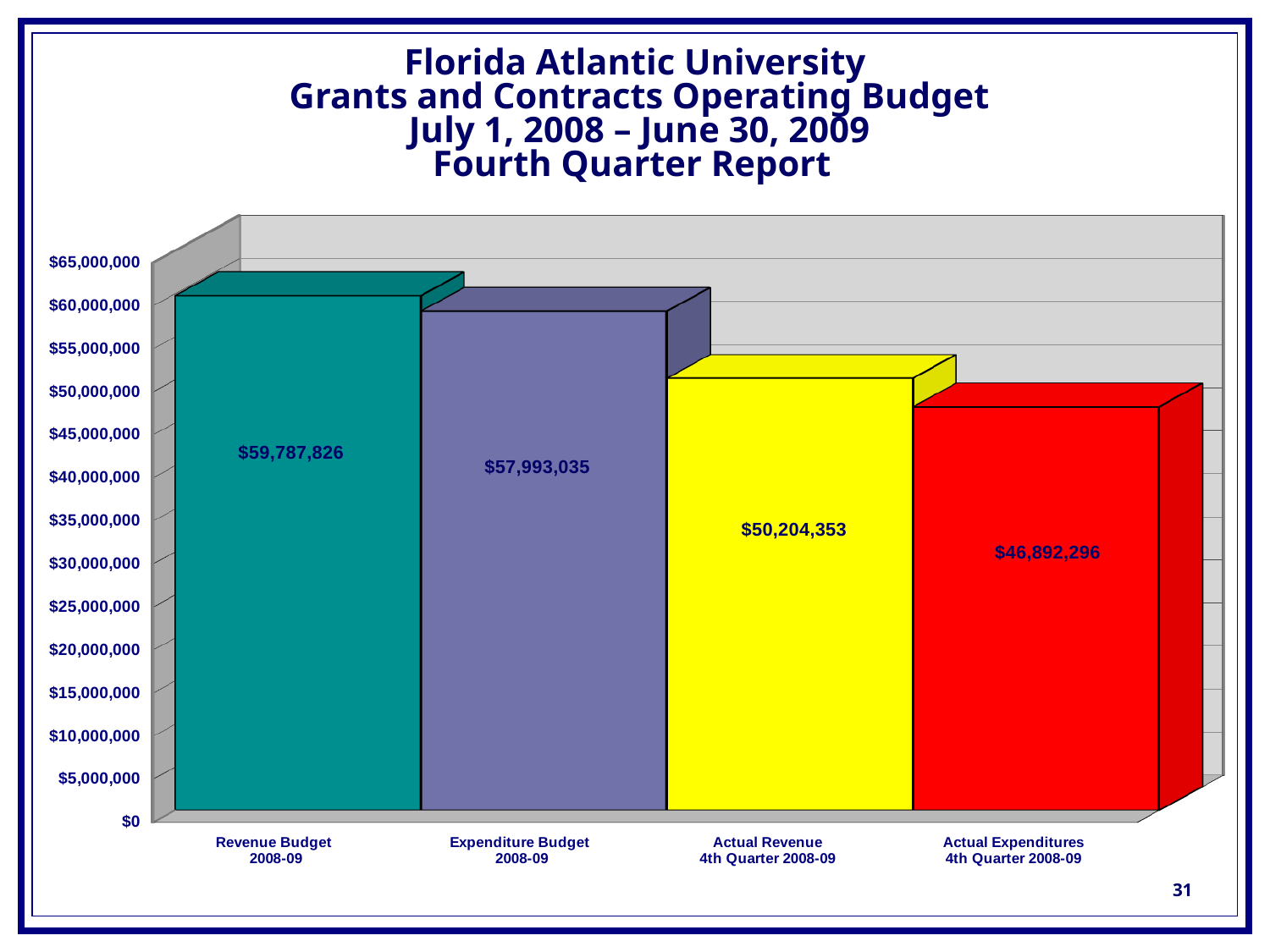
What is the value for Revenue Budget 2008-09? $59,787,826 How many bars are shown in the chart? 4 Which category has the highest value? Revenue Budget 2008-09 What is the value for Actual Expenditures 4th Quarter 2008-09? $46,892,296 What kind of chart is shown on the slide? Bar chart What is the difference between Revenue Budget 2008-09 and Expenditure Budget 2008-09? $1,794,791 What is the difference between Actual Revenue 4th Quarter 2008-09 and Actual Expenditures 4th Quarter 2008-09? $3,312,057 Do the values rise or fall from left to right across the categories? Fall Which category has the lowest value? Actual Expenditures 4th Quarter 2008-09 What is the value for Expenditure Budget 2008-09? $57,993,035 Which is larger, Expenditure Budget 2008-09 or Actual Revenue 4th Quarter 2008-09? Expenditure Budget 2008-09 What is the value for Actual Revenue 4th Quarter 2008-09? $50,204,353